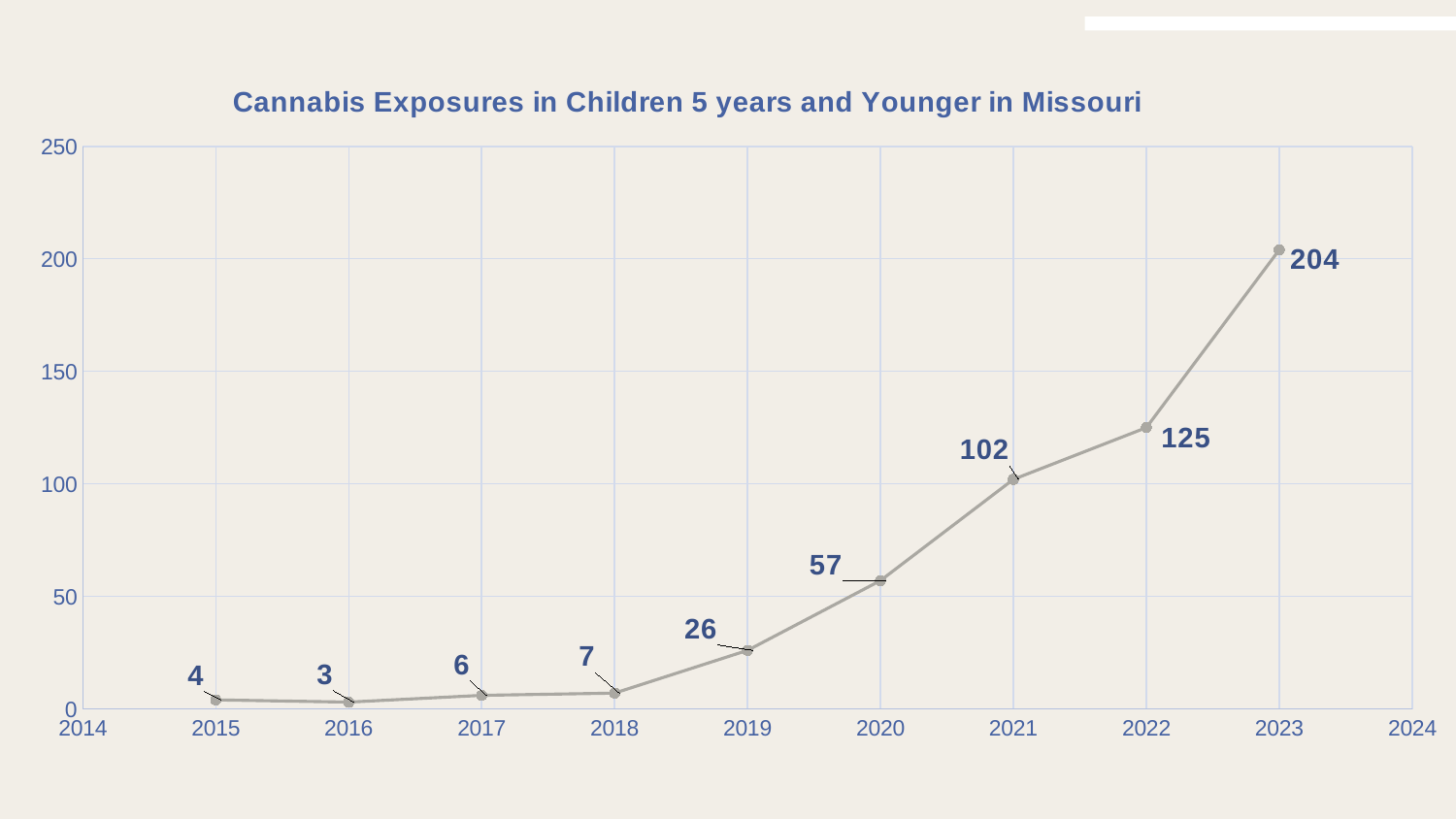
What is the number of cannabis exposures in 2019? 26 Which year has the lowest number of cannabis exposures? 2016 What is the difference in cannabis exposures between 2021 and 2020? 45 What is the difference in cannabis exposures between 2023 and 2022? 79 What is the title of the chart? Cannabis Exposures in Children 5 years and Younger in Missouri What kind of chart is shown on the slide? Line chart How many years are plotted on the chart? 9 Which year has the highest number of cannabis exposures? 2023 What is the number of cannabis exposures in 2016? 3 What is the number of cannabis exposures in 2023? 204 Which year has more cannabis exposures, 2020 or 2021? 2021 Is the value for 2022 greater or less than 100? greater